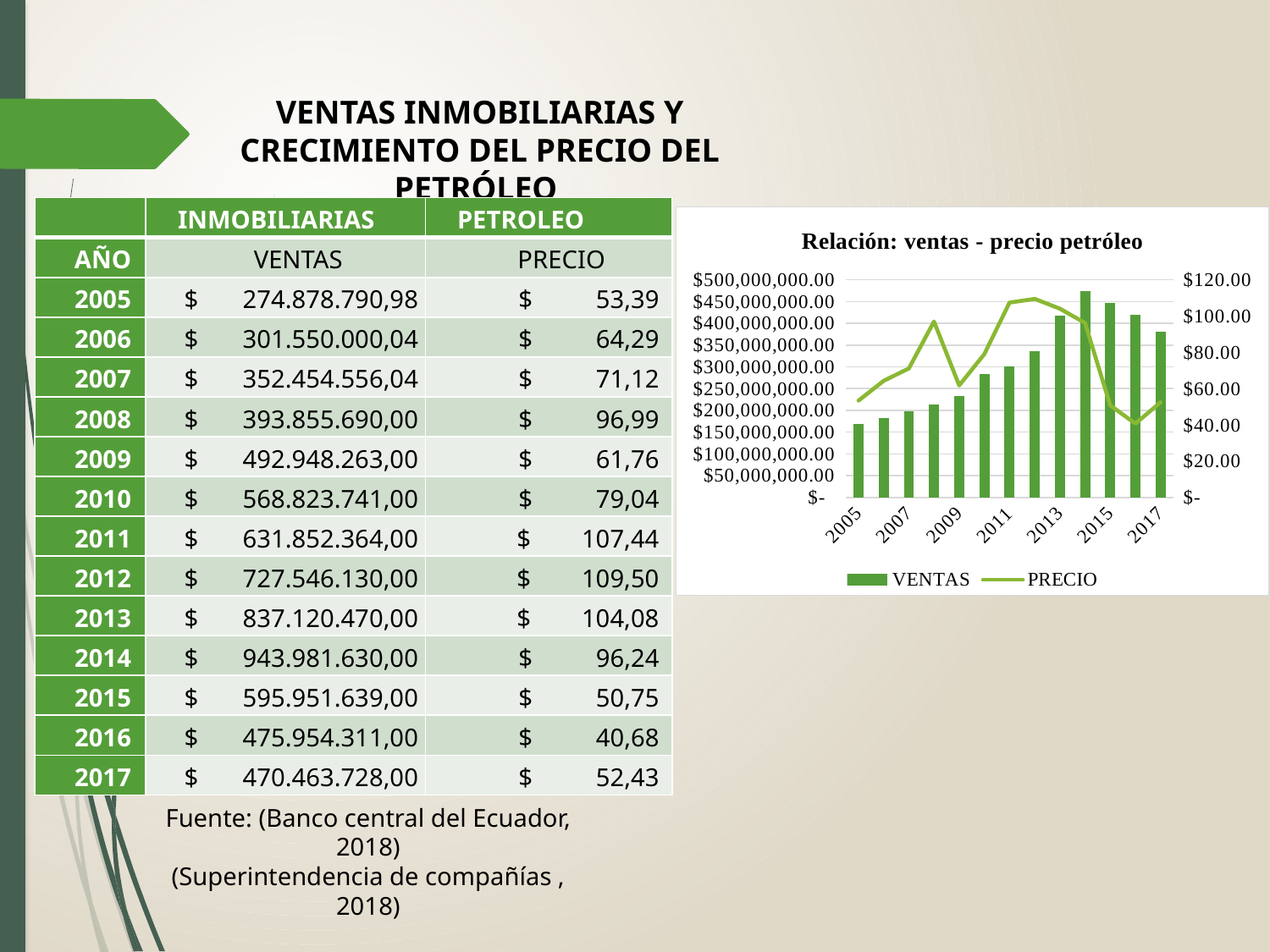
How many series does the legend of the chart list? 2 In which year does the PRECIO line reach its lowest point in the chart? 2016 Do the VENTAS bars rise or fall from 2005 to 2014 in the chart? rise In which year is the VENTAS bar the tallest in the chart? 2014 Which year has the taller VENTAS bar in the chart, 2010 or 2013? 2013 Is the PRECIO value for 2016 greater or less than $60.00? less Which series in the chart is drawn as a line? PRECIO Is the VENTAS bar for 2005 greater or less than $200,000,000.00? less What kind of chart is shown under the title 'Relación: ventas - precio petróleo'? A combination bar and line chart How many years are plotted along the x axis of the chart? 13 In which year is the VENTAS bar the shortest in the chart? 2005 Is the VENTAS bar for 2014 greater or less than $400,000,000.00? greater